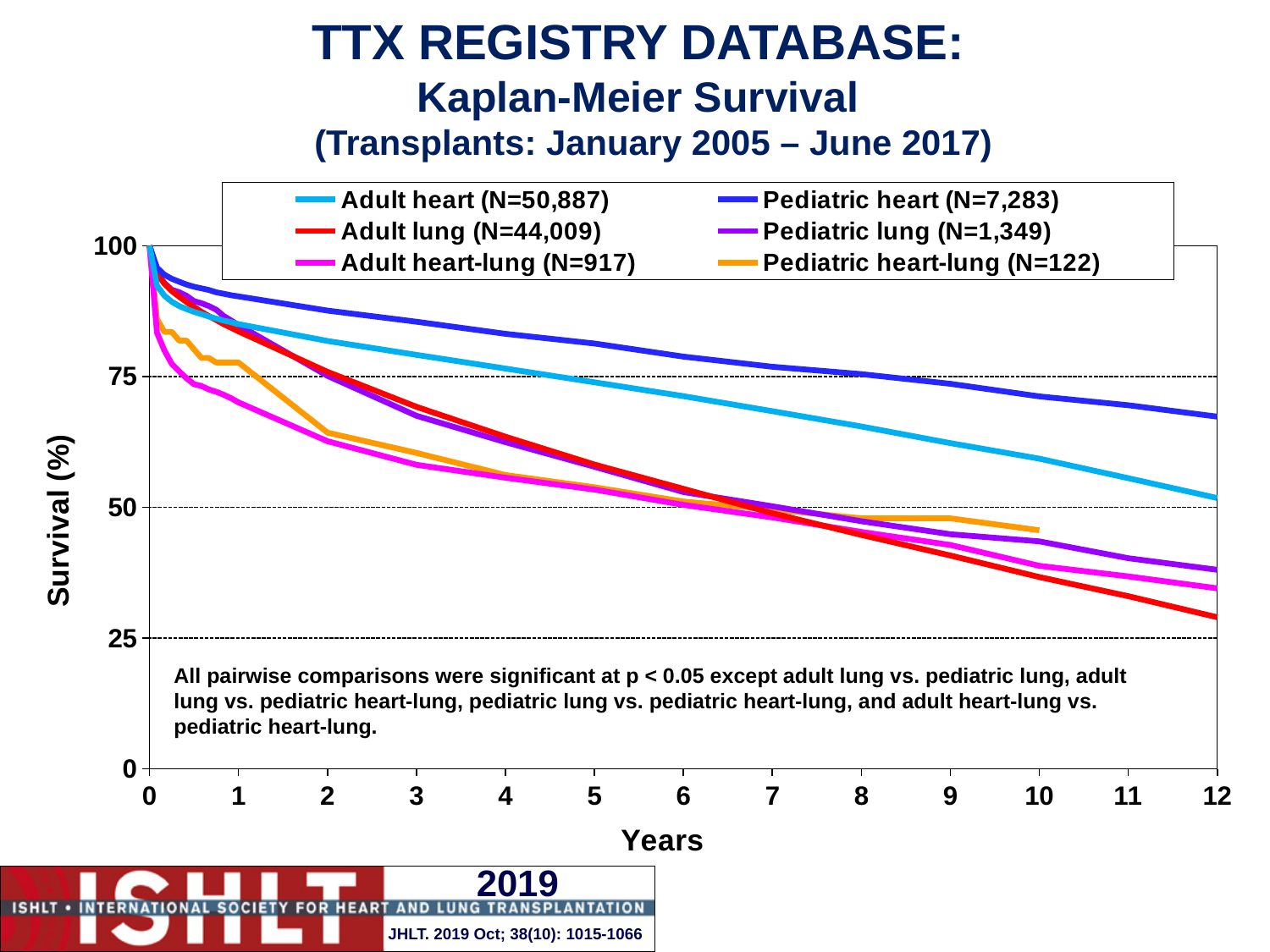
Is the survival value for Pediatric heart at 12 years greater or less than 50? greater At 12 years, which is larger: the survival for Adult heart-lung or for Adult lung? Adult heart-lung Is the survival value for Adult lung at 10 years greater or less than 50? less Do the survival curves rise or fall as the years increase? fall Which series has the lowest survival at 12 years? Adult lung Which series has the highest survival at 12 years? Pediatric heart Is the survival value for Adult heart at 2 years greater or less than 75? greater What is the N shown in the legend for Adult heart? N=50,887 How many series does the legend list? 6 What kind of chart is shown on the slide? line chart At 12 years, which is larger: the survival for Pediatric heart or for Adult heart? Pediatric heart What is the survival value for Adult heart at 0 years? 100